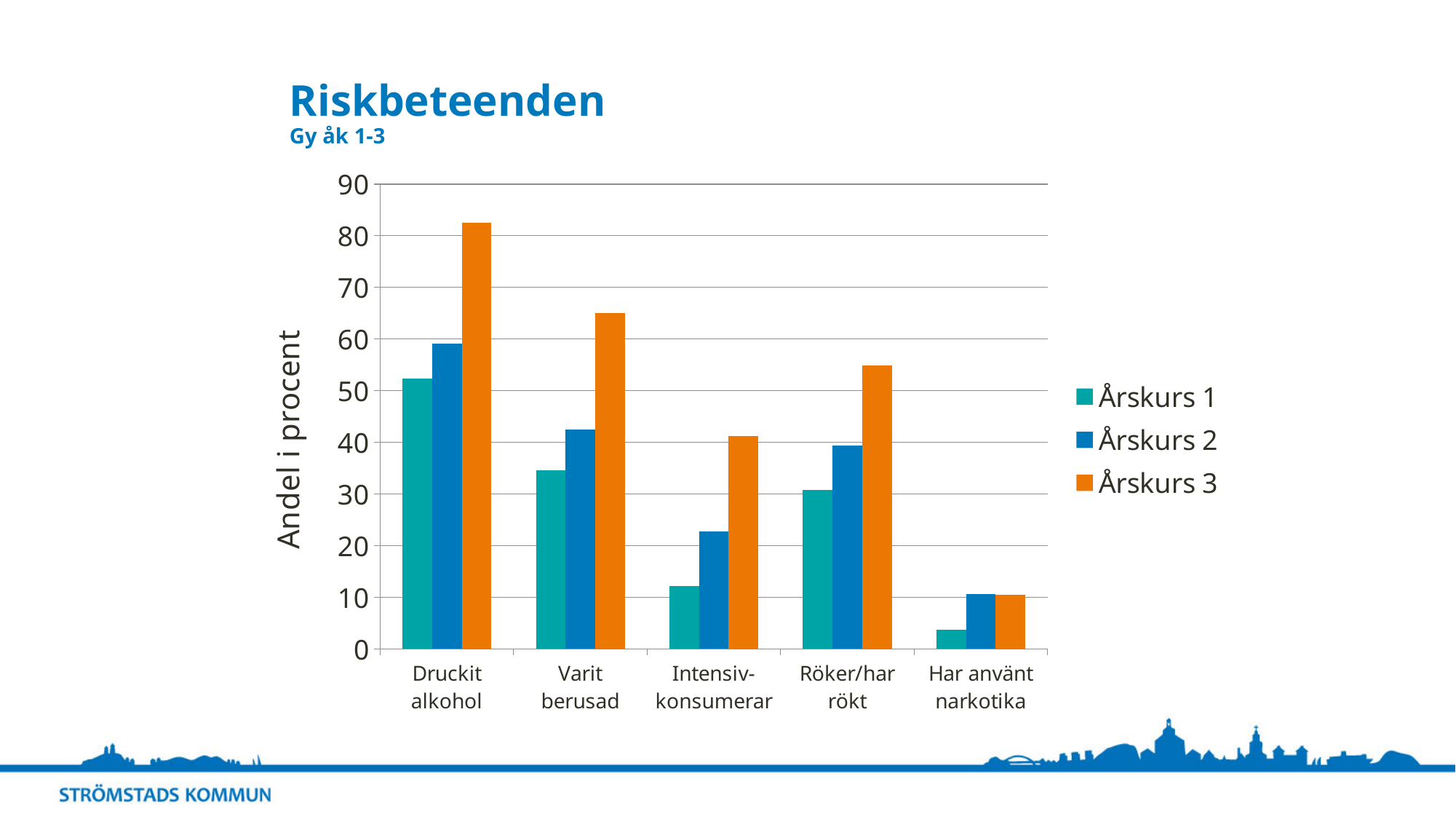
What is the label of the vertical axis? Andel i procent Is the value for Årskurs 2 in Varit berusad greater or less than 40? greater Which category has the lowest value for Årskurs 1? Har använt narkotika Is the value for Årskurs 3 in Druckit alkohol greater or less than 80? greater Is the value for Årskurs 3 in Röker/har rökt greater or less than 60? less Which category has the highest value for Årskurs 3? Druckit alkohol How many series does the legend list? 3 What is the title of the chart? Riskbeteenden How many categories are shown on the x axis? 5 Which is larger in Röker/har rökt: Årskurs 1 or Årskurs 2? Årskurs 2 What kind of chart is shown on the slide? bar chart